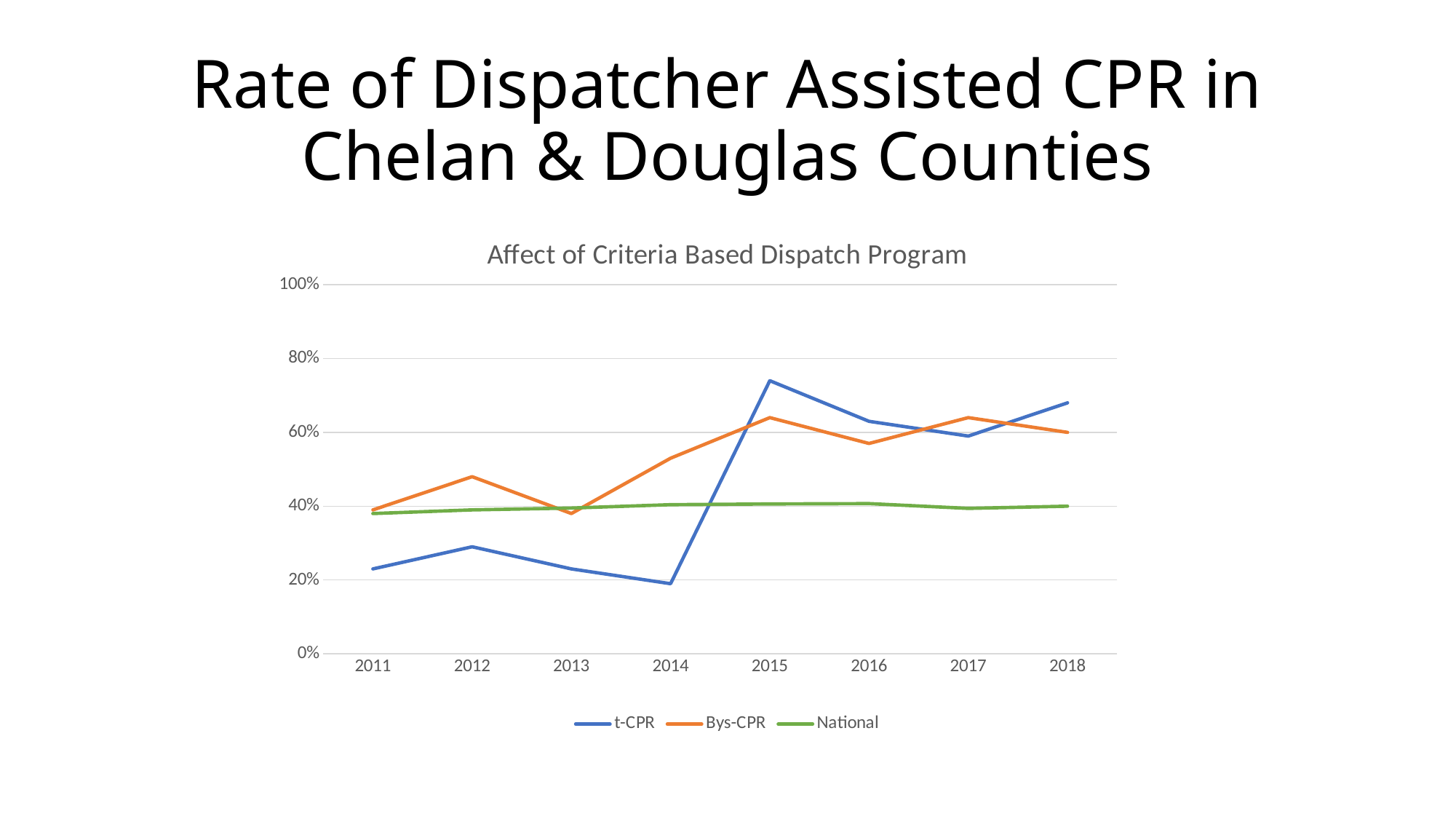
In which year is the t-CPR value lowest? 2014 Is the t-CPR value for 2015 greater or less than 60%? greater In 2015, which is larger, t-CPR or Bys-CPR? t-CPR In which year is the t-CPR value highest? 2015 How many years are plotted along the x axis? 8 What kind of chart is shown on the slide? line chart Is the National value for 2016 greater or less than 60%? less How many series does the legend list? 3 Which series is drawn in green? National Is the Bys-CPR value for 2014 greater or less than 40%? greater What is the title of the chart? Affect of Criteria Based Dispatch Program Does the t-CPR line rise or fall from 2014 to 2015? rise